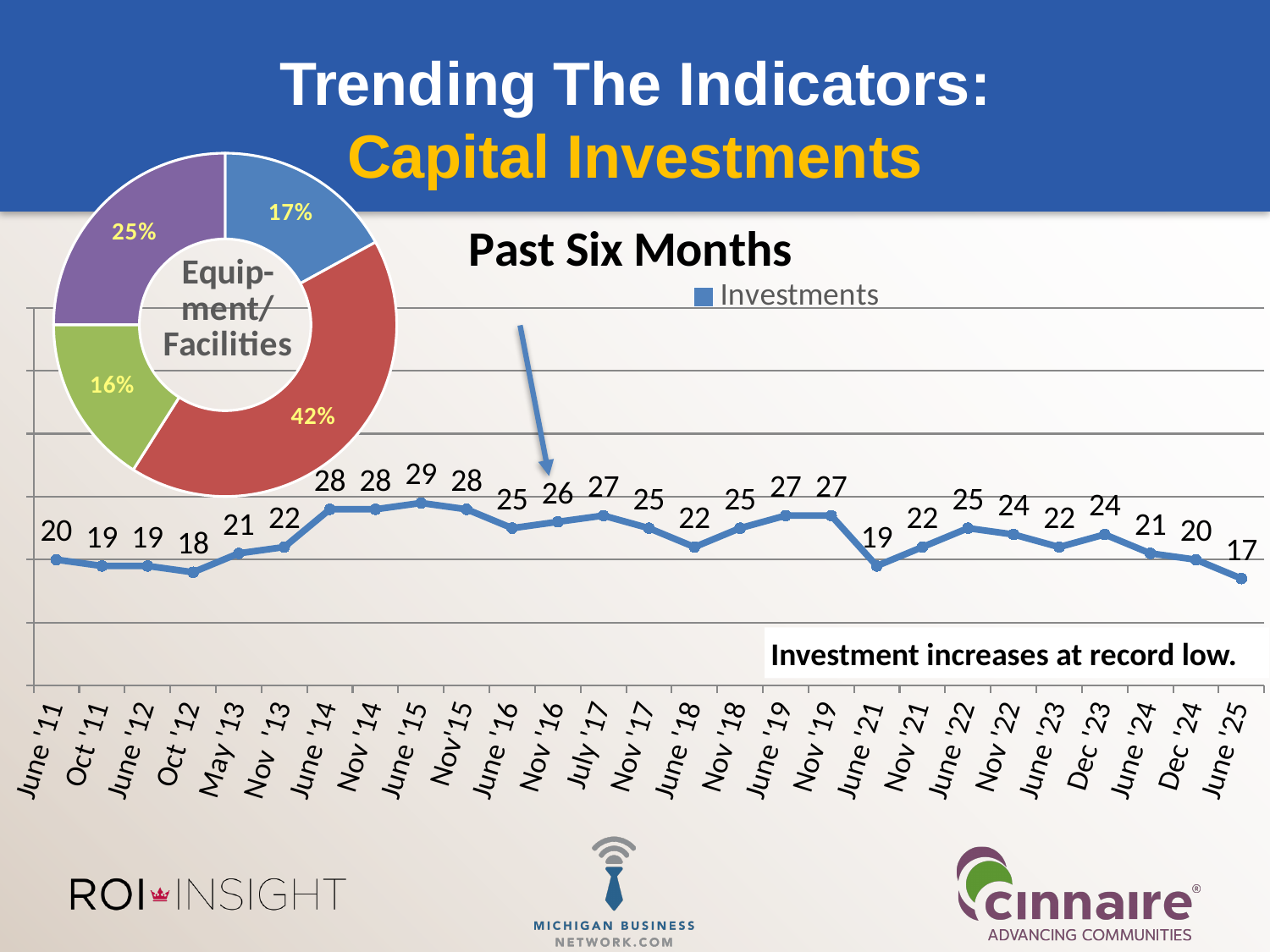
What type of chart is the "Past Six Months" chart? Line chart How many data points are plotted in the "Past Six Months" line chart? 27 In the "Equipment/Facilities" donut chart, what share does the largest slice have? 42% In the "Past Six Months" line chart, which period has the highest value? June '15 How many slices does the "Equipment/Facilities" donut chart have? 4 In the "Past Six Months" line chart, what is the value for June '11? 20 In the "Past Six Months" line chart, which is larger, the value for Nov '13 or the value for June '14? June '14 In the "Past Six Months" line chart, what is the value for June '25? 17 What type of chart is the "Equipment/Facilities" chart? Donut chart In the "Past Six Months" line chart, what is the difference between the values for June '15 and June '25? 12 In the "Past Six Months" line chart, which period has the lowest value? June '25